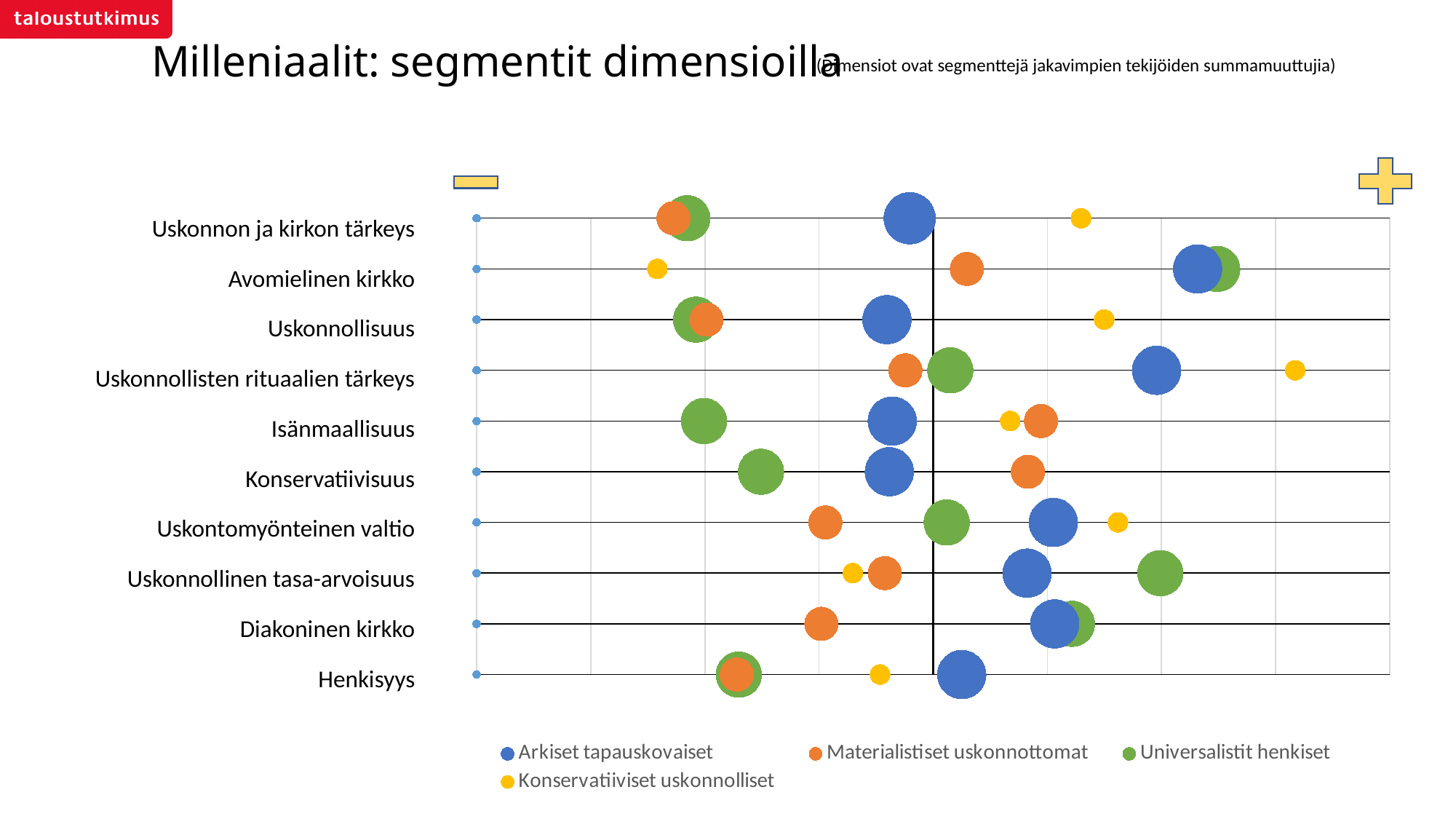
For the dimension 'Henkisyys', which series has the bubble furthest to the right? Arkiset tapauskovaiset Which colour represents the series 'Arkiset tapauskovaiset' in the legend? blue What kind of chart is shown on the slide? bubble chart How many dimensions (categories) are listed on the vertical axis of the chart? 10 For the dimension 'Uskonnollinen tasa-arvoisuus', which series has the bubble furthest to the right? Universalistit henkiset For the dimension 'Konservatiivisuus', which series has the bubble furthest to the left? Universalistit henkiset How many series does the chart legend list? 4 What is the title of the chart on the slide? Milleniaalit: segmentit dimensioilla